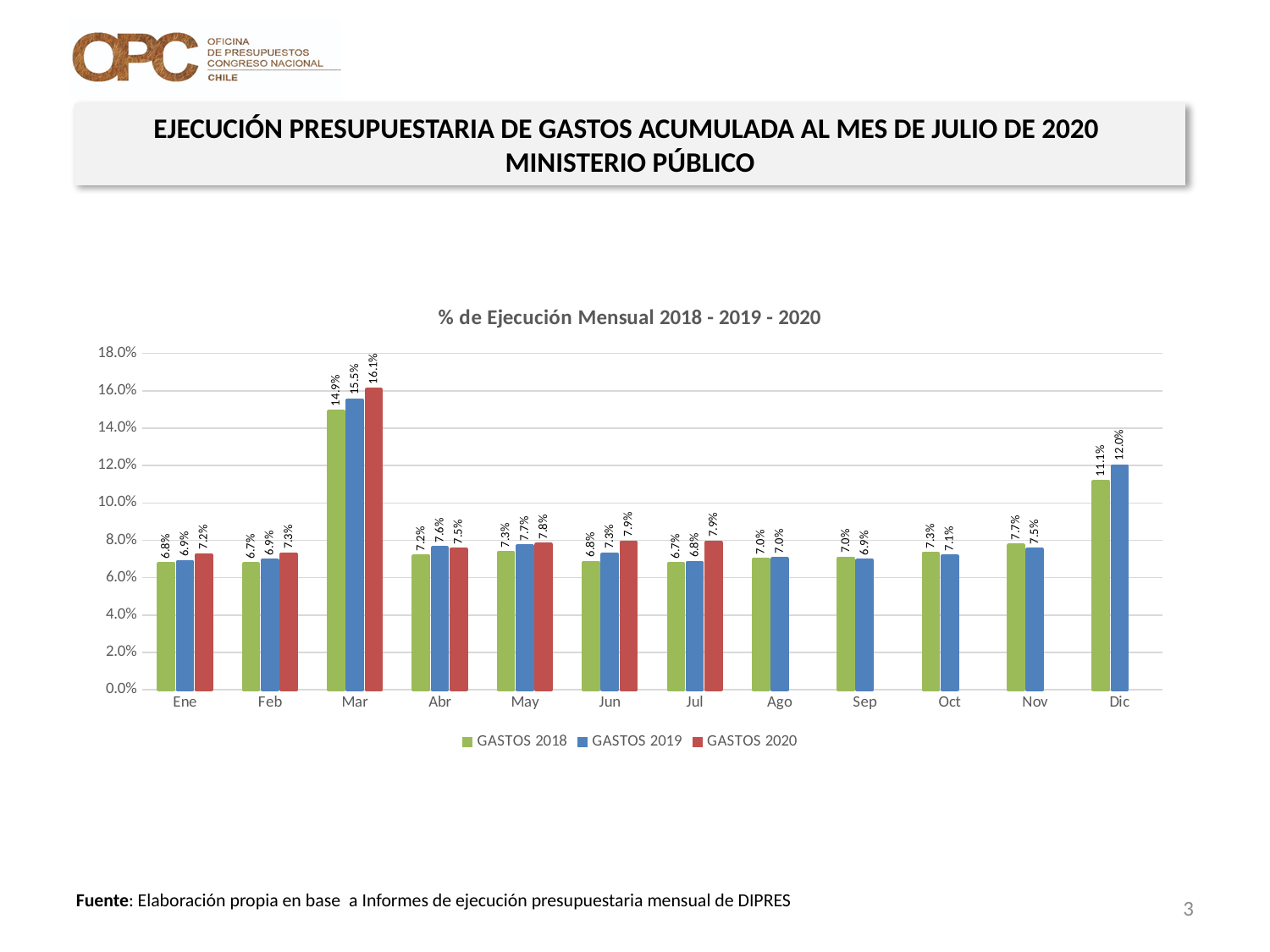
What is the value for GASTOS 2019 in Jun? 7.3% What is the difference between GASTOS 2020 and GASTOS 2018 in Jul? 1.2% Which month has the lowest value for GASTOS 2020? Ene Which is larger in Abr: GASTOS 2019 or GASTOS 2020? GASTOS 2019 What is the value for GASTOS 2020 in Mar? 16.1% How many series does the legend list? 3 Which month has the highest value for GASTOS 2019? Mar What kind of chart is shown on the slide? Bar chart Is the value for GASTOS 2019 in Dic greater or less than 10.0%? greater What is the value for GASTOS 2018 in Dic? 11.1% How many months are shown on the x axis? 12 What is the title of the chart? % de Ejecución Mensual 2018 - 2019 - 2020